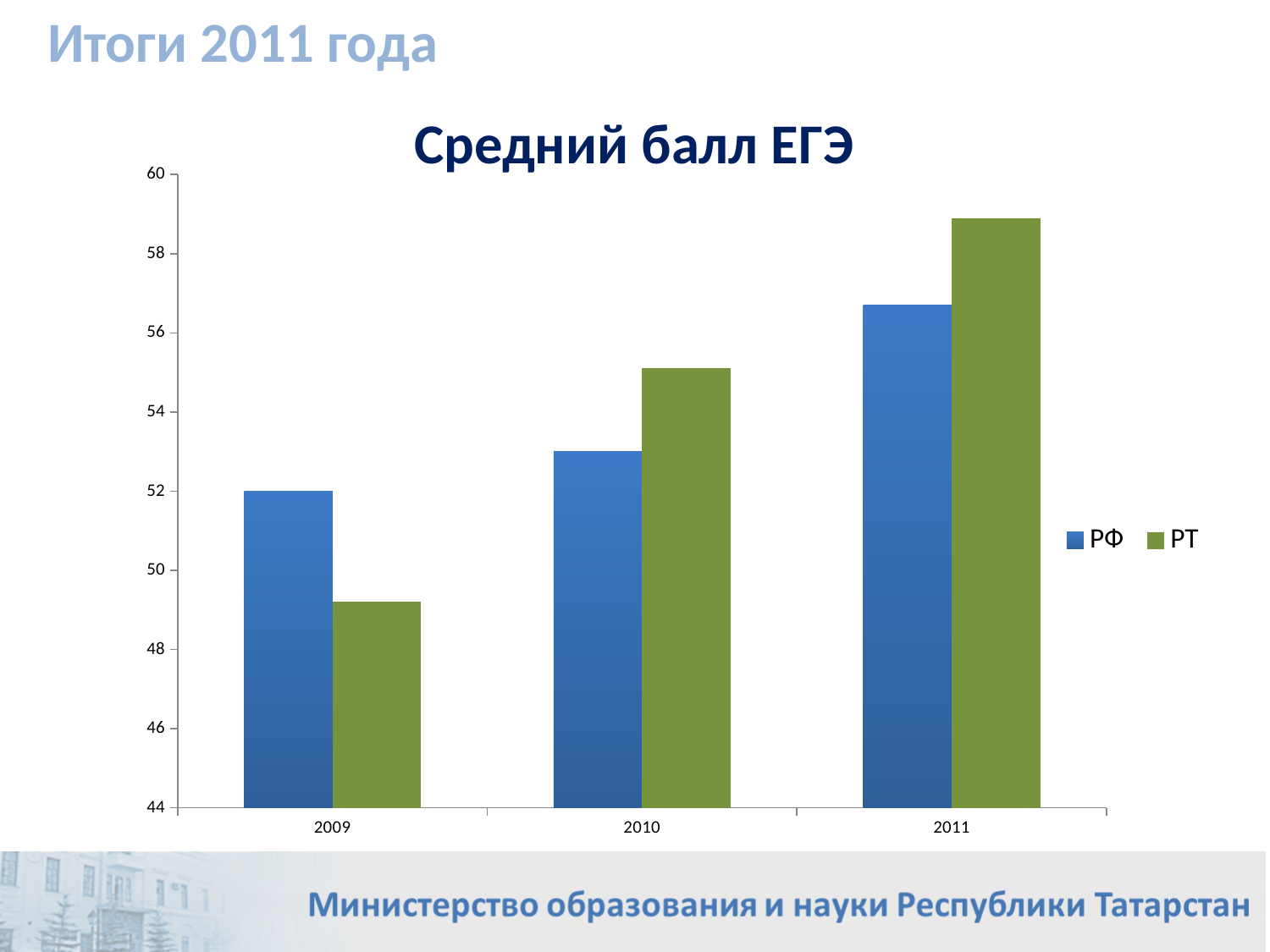
In 2011, which is larger, the value for РФ or the value for РТ? РТ In 2009, which is larger, the value for РФ or the value for РТ? РФ Is the value for РТ in 2011 greater or less than 58? greater Is the value for РТ in 2009 greater or less than 50? less Is the value for РФ in 2011 greater or less than 56? greater Do the values for РФ rise or fall from 2009 to 2011? rise How many series does the legend list? 2 How many years are shown on the x axis? 3 Which year has the highest value for РТ? 2011 What is the title of the chart? Средний балл ЕГЭ What kind of chart is shown on the slide? bar chart Which year has the lowest value for РТ? 2009